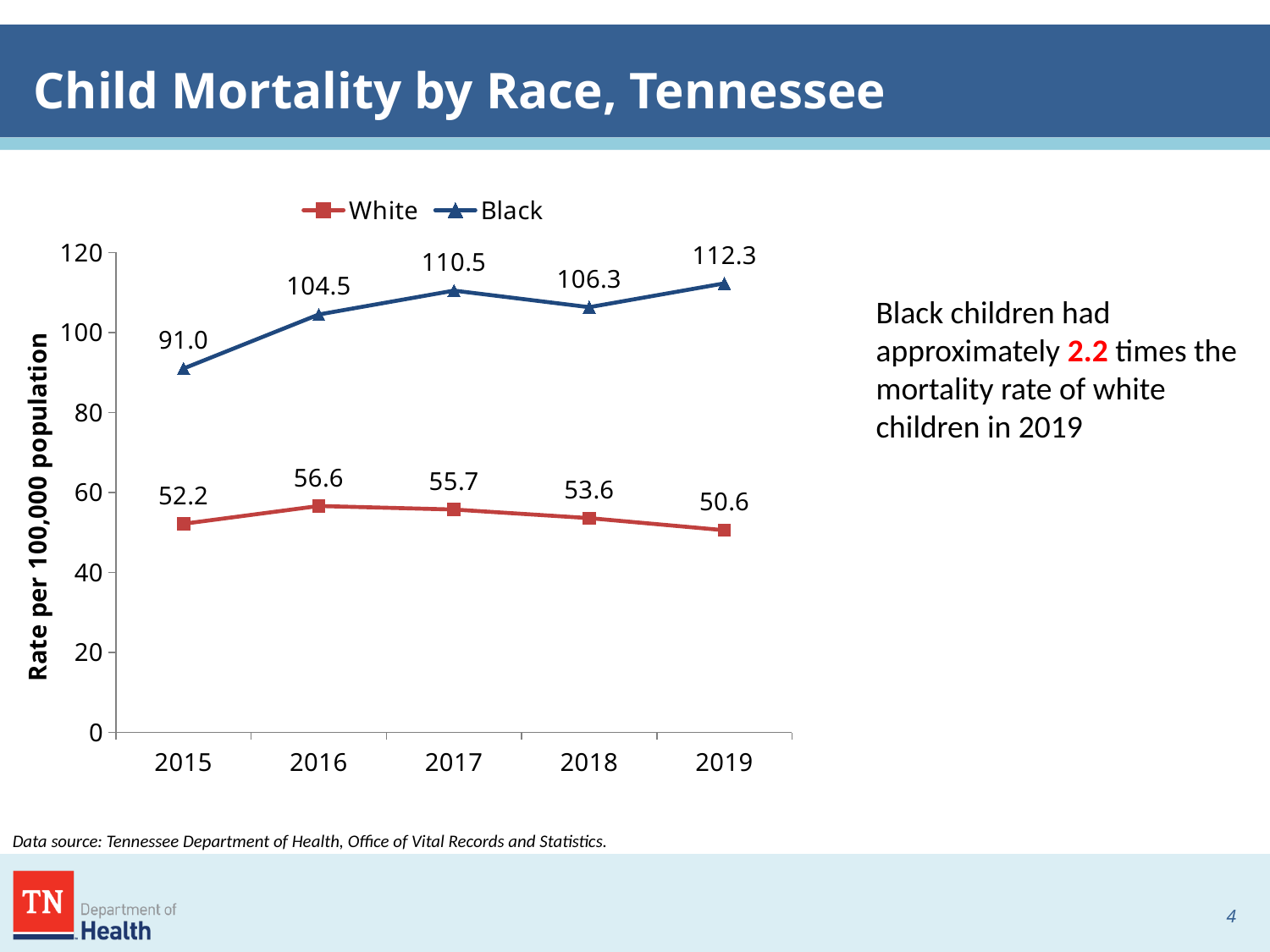
How many years are shown on the x axis? 5 What was the child mortality rate for Black children in 2019? 112.3 What kind of chart is shown on the slide? Line chart What is the difference between the Black and White child mortality rates in 2015? 38.8 What was the child mortality rate for White children in 2016? 56.6 Is the Black child mortality rate in 2015 greater or less than 100? less Did the White child mortality rate rise or fall from 2016 to 2019? Fall Which series had the higher value in 2017, White or Black? Black How many series does the legend list? 2 In which year was the Black child mortality rate highest? 2019 In which year was the White child mortality rate lowest? 2019 What is the label of the y axis? Rate per 100,000 population